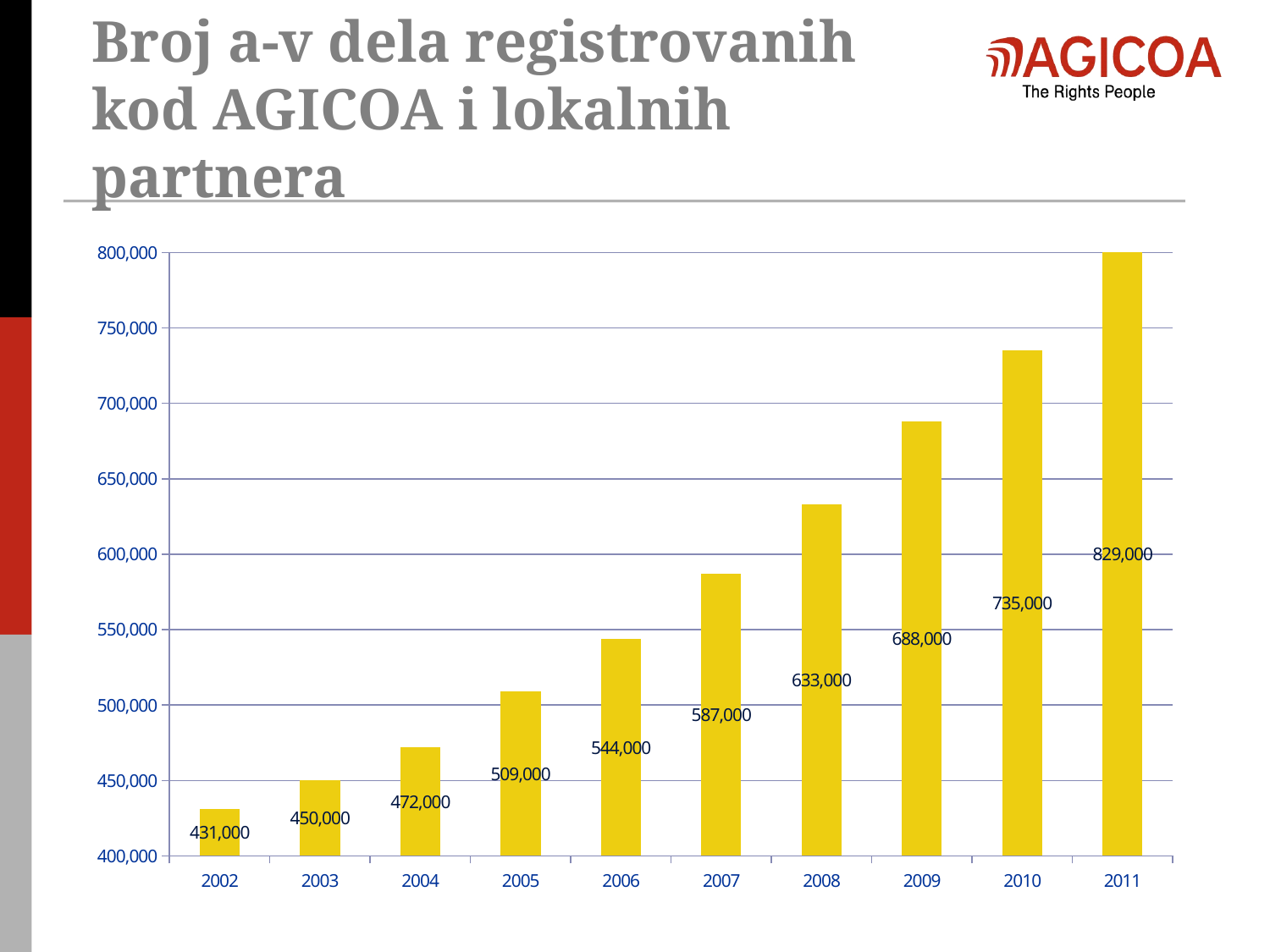
What is the value for 2007? 587,000 What kind of chart is shown on the slide? Bar chart What is the value for 2010? 735,000 Do the values rise or fall from 2002 to 2011? Rise What is the difference between the values for 2009 and 2008? 55,000 What is the value for 2002? 431,000 How many years are shown on the x axis? 10 Is the value for 2008 greater or less than 600,000? greater Which year has the highest value? 2011 What is the difference between the values for 2011 and 2002? 398,000 Which year has the lowest value? 2002 Which is larger, the value for 2005 or the value for 2006? 2006